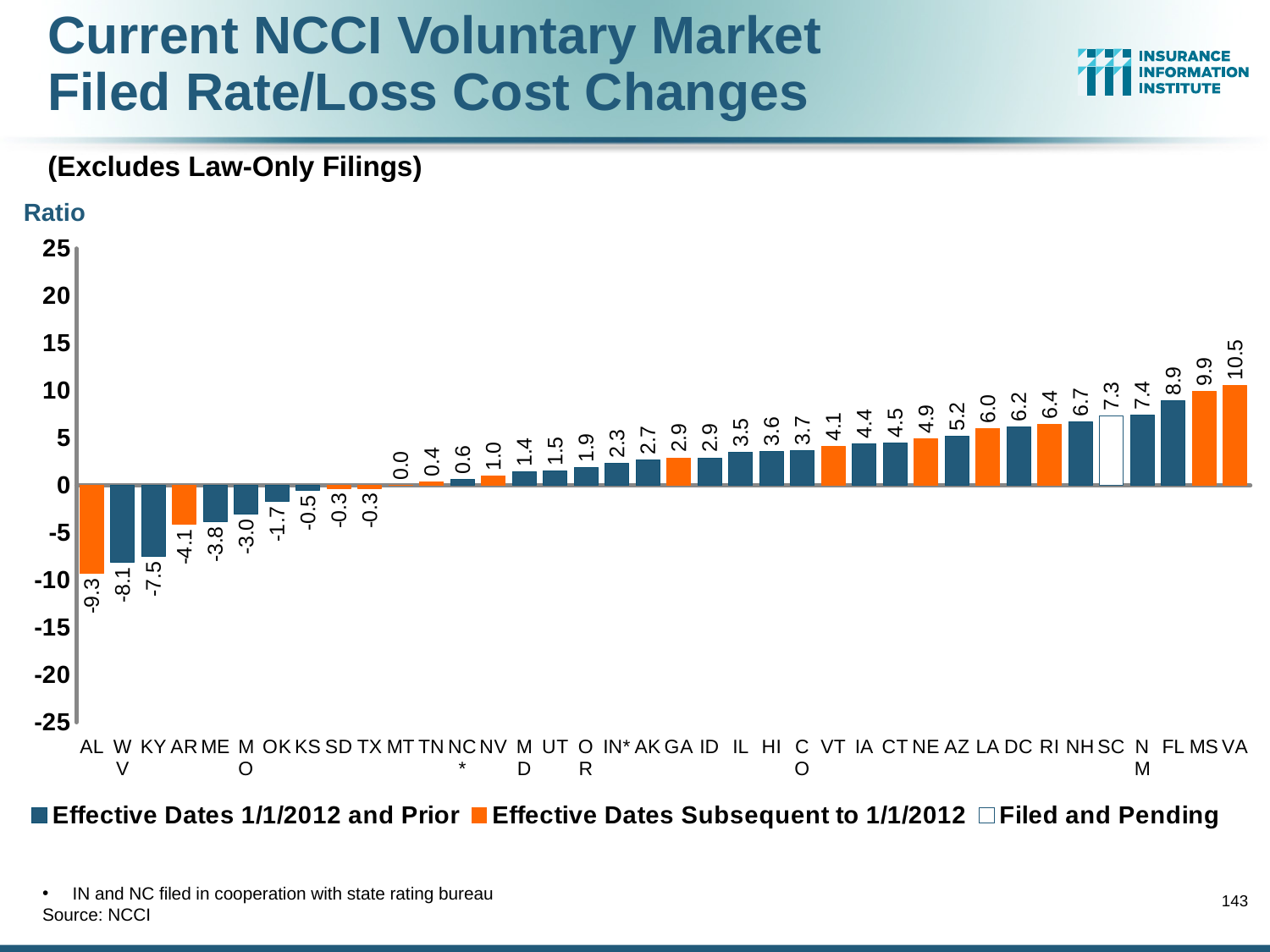
What type of chart is shown on the slide? bar chart What is the value for VA? 10.5 How many series does the legend list? 3 What is the value for FL? 8.9 Is the value for VA greater or less than 10? greater What is the difference between the values for VA and AL? 19.8 Which state's bar is shown as Filed and Pending? SC Which state has the highest value? VA Which has a larger value, MS or FL? MS What is the value for KY? -7.5 Which state has the lowest value? AL Do the values rise or fall from left to right along the x axis? rise